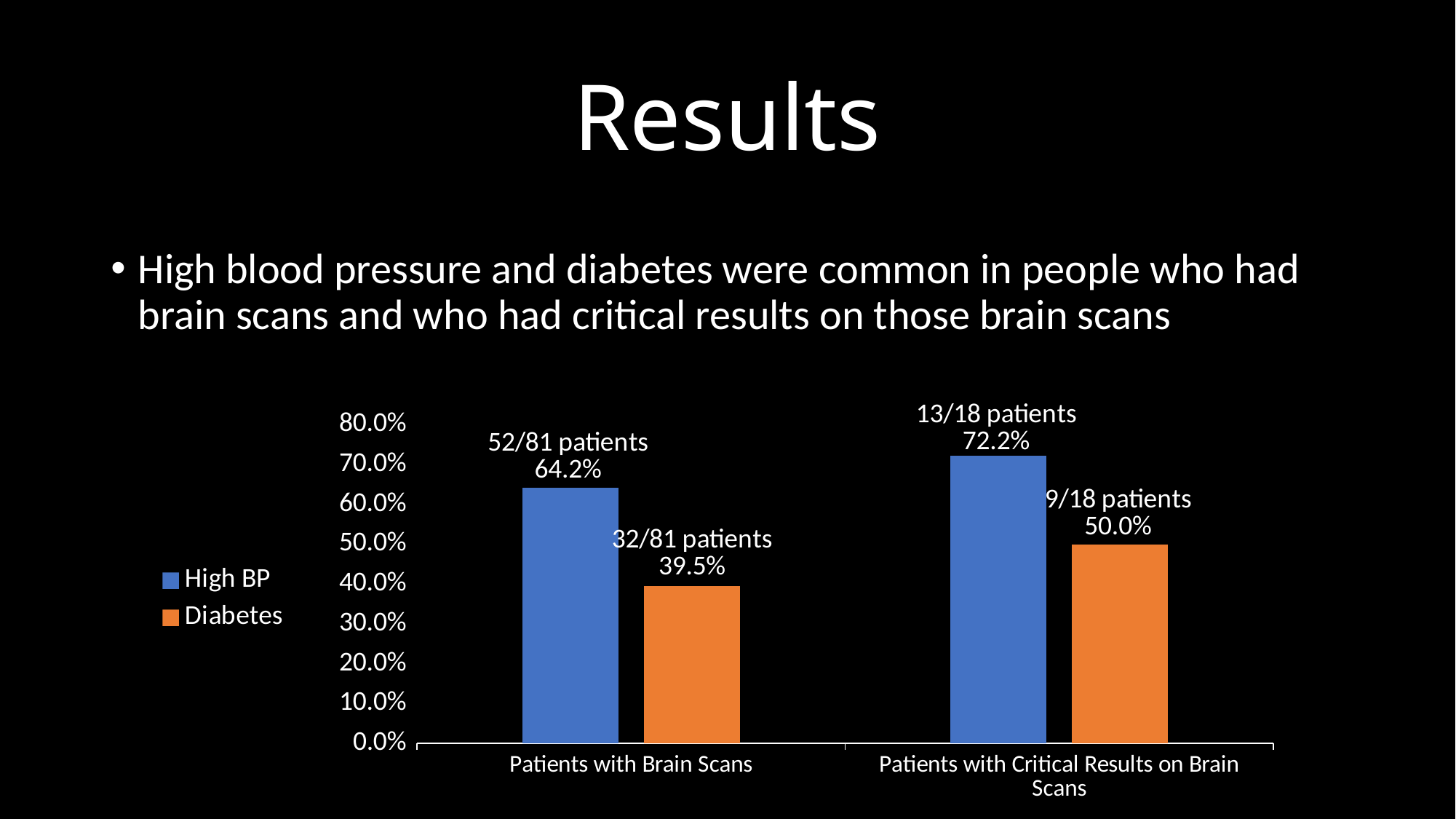
What is the value for High BP among Patients with Brain Scans? 64.2% Which bar has the lowest value on the chart? Diabetes, Patients with Brain Scans What kind of chart is shown on the slide? Bar chart What colour represents the Diabetes series in the chart? Orange What is the value for Diabetes among Patients with Brain Scans? 39.5% What is the value for Diabetes among Patients with Critical Results on Brain Scans? 50.0% How many series does the legend list? 2 What is the value for High BP among Patients with Critical Results on Brain Scans? 72.2% Which is larger: the High BP value for Patients with Brain Scans or the High BP value for Patients with Critical Results on Brain Scans? Patients with Critical Results on Brain Scans What is the difference between the High BP and Diabetes values for Patients with Brain Scans? 24.7% How many patients with brain scans had high BP, as labelled on the chart? 52/81 patients Which bar has the highest value on the chart? High BP, Patients with Critical Results on Brain Scans